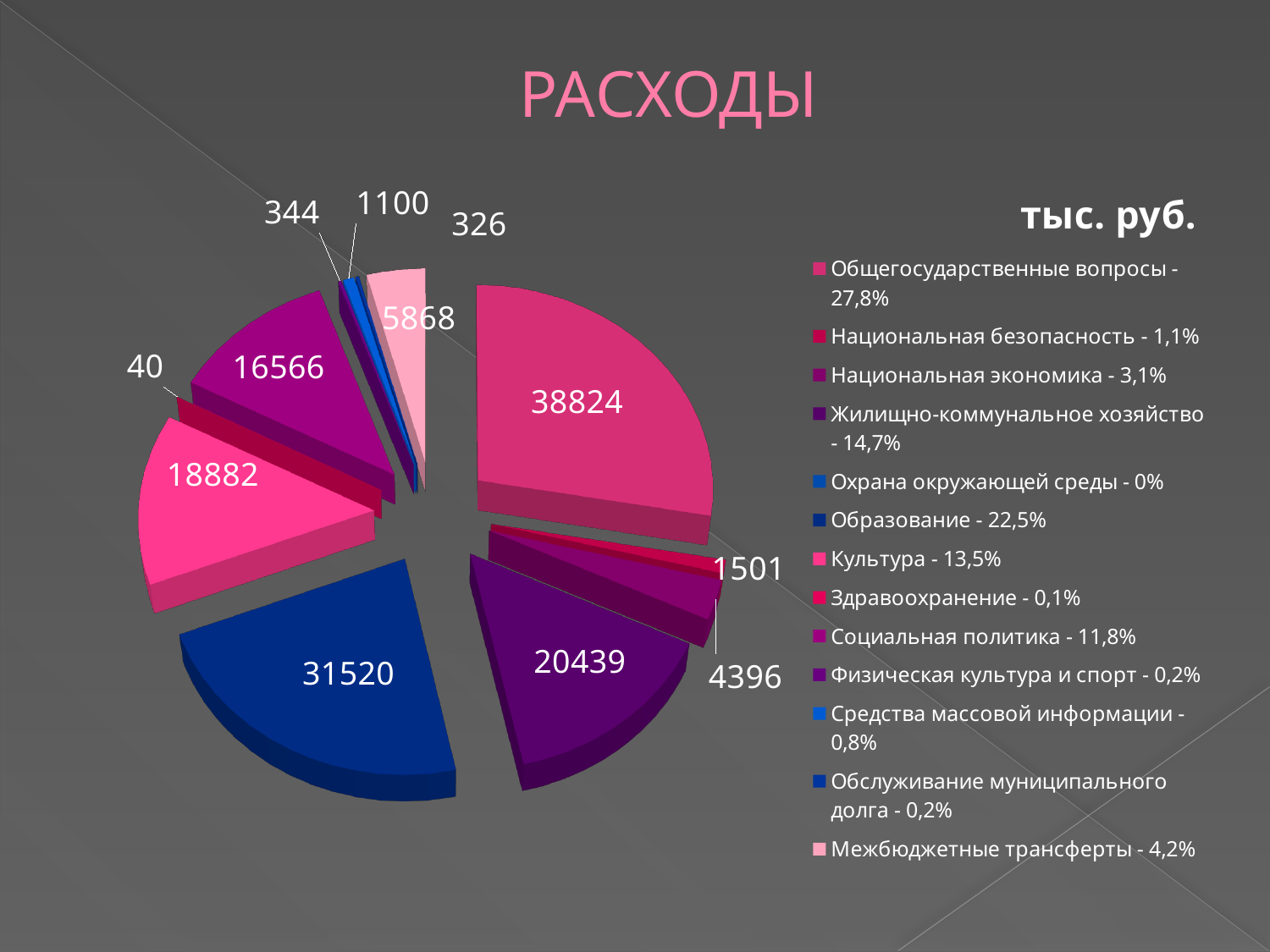
What is the value of the slice for Образование? 31520 What is the value of the slice for Жилищно-коммунальное хозяйство? 20439 Which category has the largest share of the pie? Общегосударственные вопросы What share of the pie does Межбюджетные трансферты have, according to the legend? 4,2% What share of the pie does Культура have, according to the legend? 13,5% Which is larger: the slice for Культура (18882) or the slice for Социальная политика (16566)? Культура How many categories does the legend list? 13 What is the difference between the largest slice (38824) and the slice for Образование (31520)? 7304 What is the title of the chart? тыс. руб. What is the value of the largest slice of the pie? 38824 What unit is indicated above the legend? тыс. руб. What kind of chart is shown on the slide? pie chart